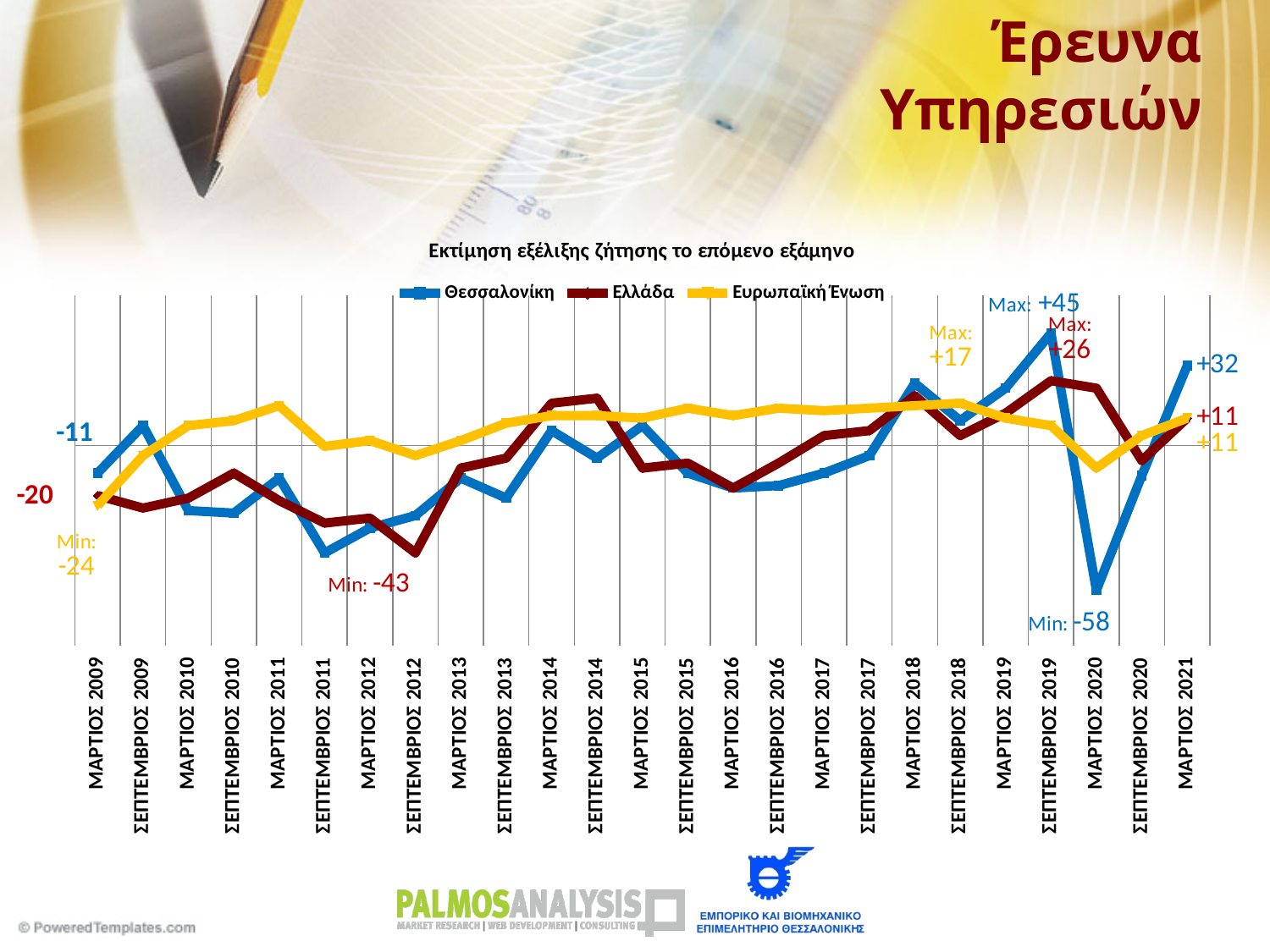
What kind of chart is shown on the slide? Line chart What is the title of the chart? Εκτίμηση εξέλιξης ζήτησης το επόμενο εξάμηνο What is the maximum value reached by the Θεσσαλονίκη series? +45 How many time periods are shown on the x axis? 25 What is the difference between the Θεσσαλονίκη value and the Ελλάδα value in ΜΑΡΤΙΟΣ 2021? 21 What is the maximum value of the Ευρωπαϊκή Ένωση series? +17 In ΣΕΠΤΕΜΒΡΙΟΣ 2019, which series has the higher value, Θεσσαλονίκη or Ελλάδα? Θεσσαλονίκη What is the minimum value of the Ελλάδα series? -43 How many series does the legend list? 3 What is the value for Θεσσαλονίκη in ΜΑΡΤΙΟΣ 2021? +32 What is the value for Ελλάδα in ΜΑΡΤΙΟΣ 2009? -20 In which period does the Θεσσαλονίκη series reach its minimum? ΜΑΡΤΙΟΣ 2020